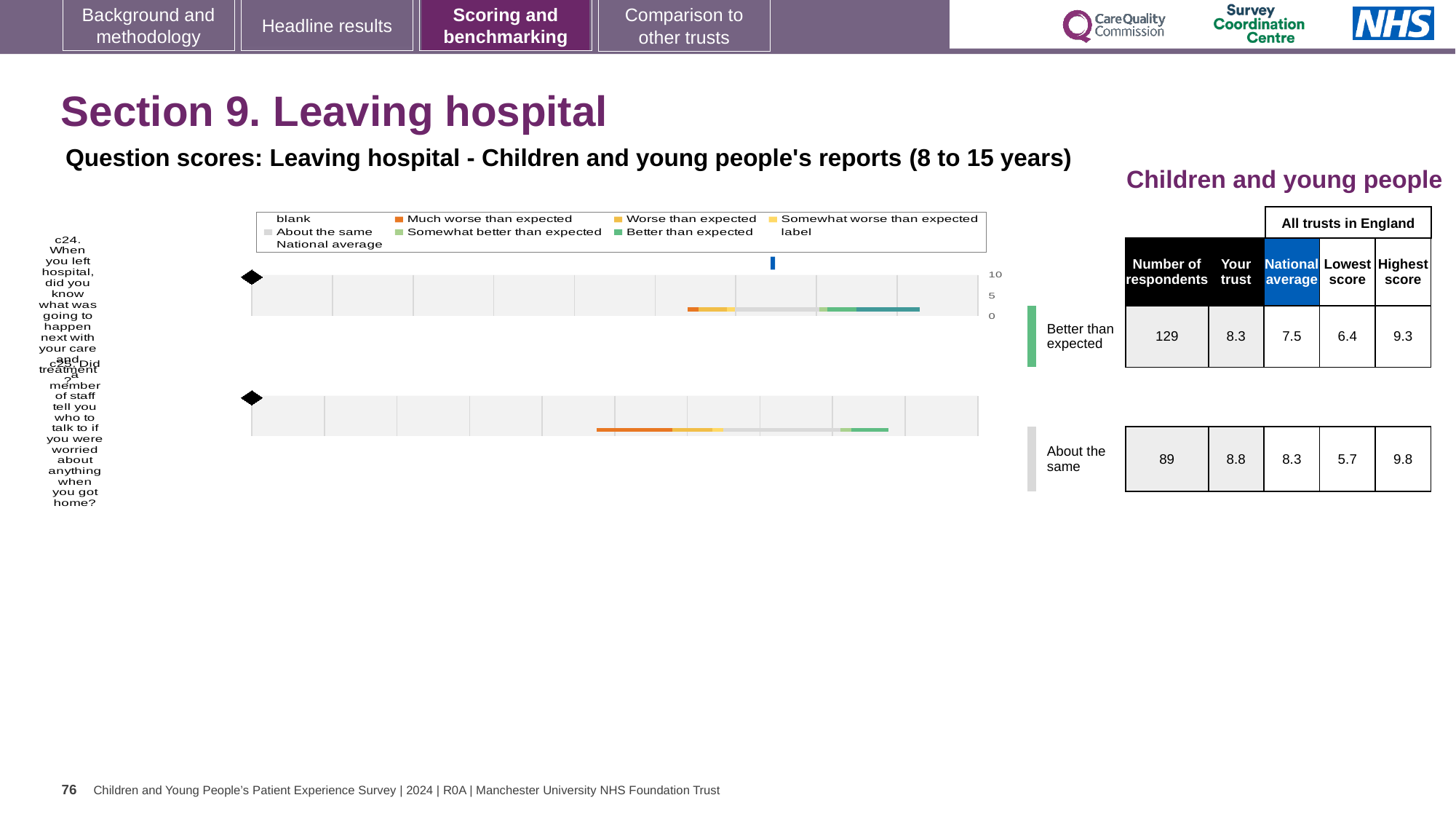
How many questions (bars) are plotted in the Leaving hospital chart? 2 What is the national average score for question c25 (did a member of staff tell you who to talk to if you were worried)? 8.3 What kind of chart is used to show the question scores for Leaving hospital? bar chart What is the 'Your trust' score for question c24 (did you know what was going to happen next with your care and treatment)? 8.3 What is the highest score among all trusts in England for question c25? 9.8 How many respondents answered question c24? 129 What is the difference between the highest and lowest trust scores for question c25? 4.1 Which benchmark category is question c24 placed in? Better than expected Which question had more respondents, c24 or c25? c24 What is the lowest score among all trusts in England for question c24? 6.4 Which question has the higher 'Your trust' score, c24 or c25? c25 By how much does the trust's score for c24 exceed the national average for c24? 0.8